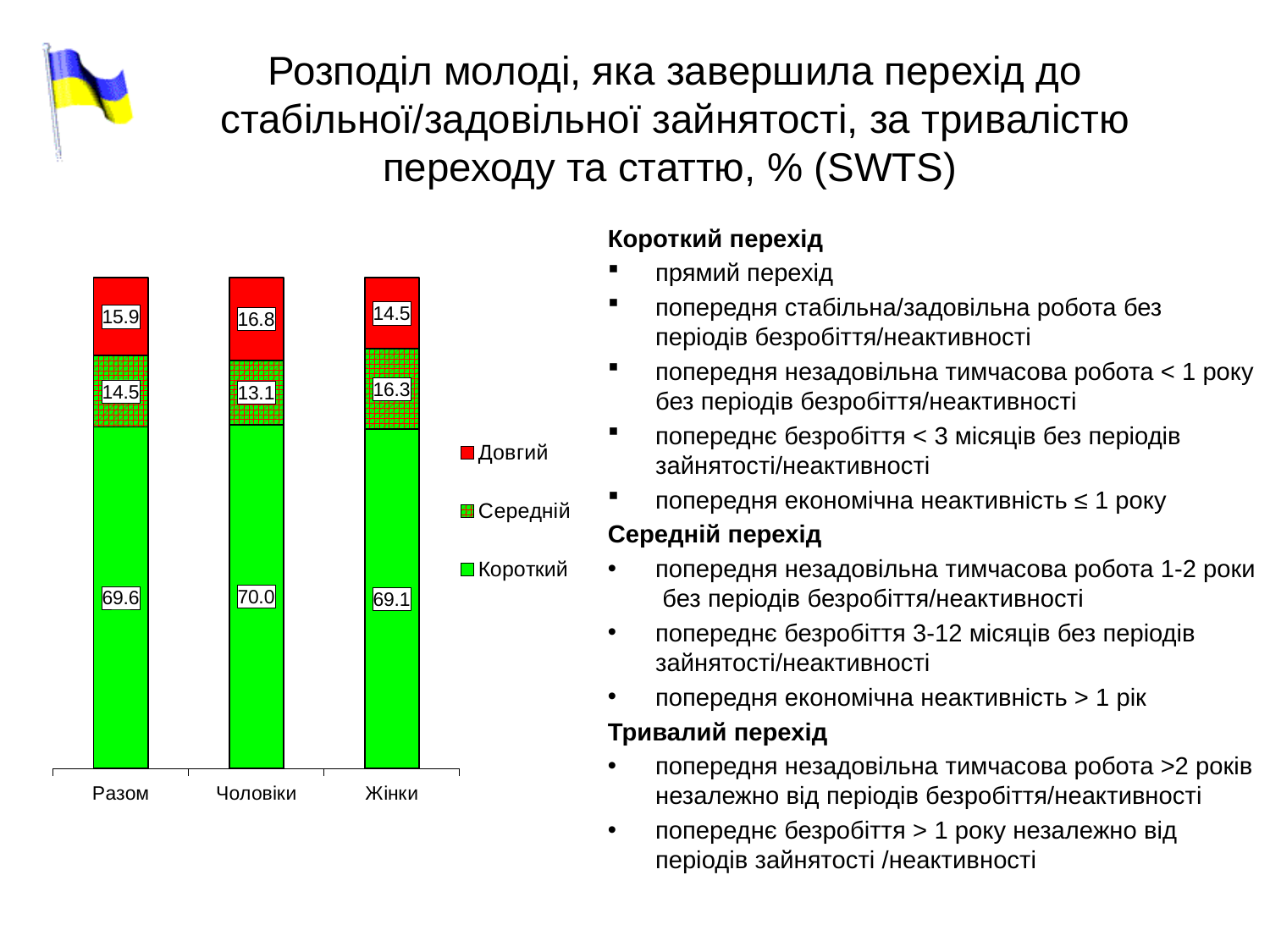
Which category has the lowest value for the Довгий series? Жінки Which is larger: the Середній value for Чоловіки or for Жінки? Жінки What kind of chart is shown on the slide? Stacked bar chart What is the value of the Довгий series for Жінки? 14.5 What is the total of the stacked bar for Разом? 100.0 How many series does the chart legend list? 3 What is the difference between the Довгий values for Чоловіки and Жінки? 2.3 What is the value of the Середній series for Разом? 14.5 Which category has the highest value for the Середній series? Жінки Which series is shown in red in the chart legend? Довгий How many categories are shown on the x axis of the chart? 3 What is the value of the Короткий series for Чоловіки? 70.0